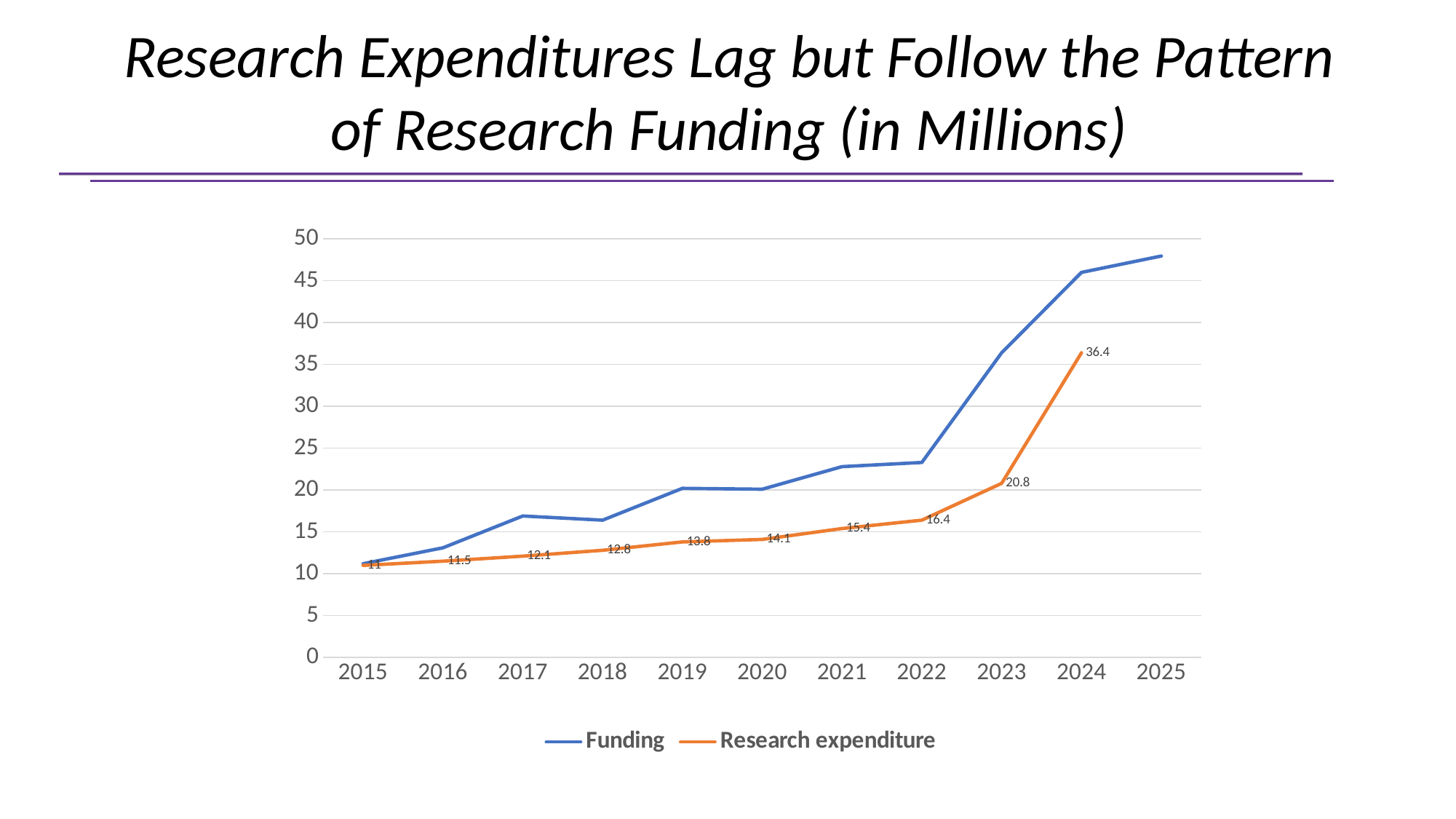
In which year is Research expenditure lowest? 2015 What is the Research expenditure value for 2024? 36.4 In which year is Research expenditure highest? 2024 How many series does the legend list? 2 Is the Funding value for 2019 greater or less than 25? less In 2023, which is larger: Funding or Research expenditure? Funding Is the Funding value for 2024 greater or less than 40? greater What is the Research expenditure value for 2023? 20.8 What kind of chart is shown on the slide? line chart What is the difference in Research expenditure between 2022 and 2023? 4.4 By how much did Research expenditure increase from 2023 to 2024? 15.6 What is the Research expenditure value for 2019? 13.8